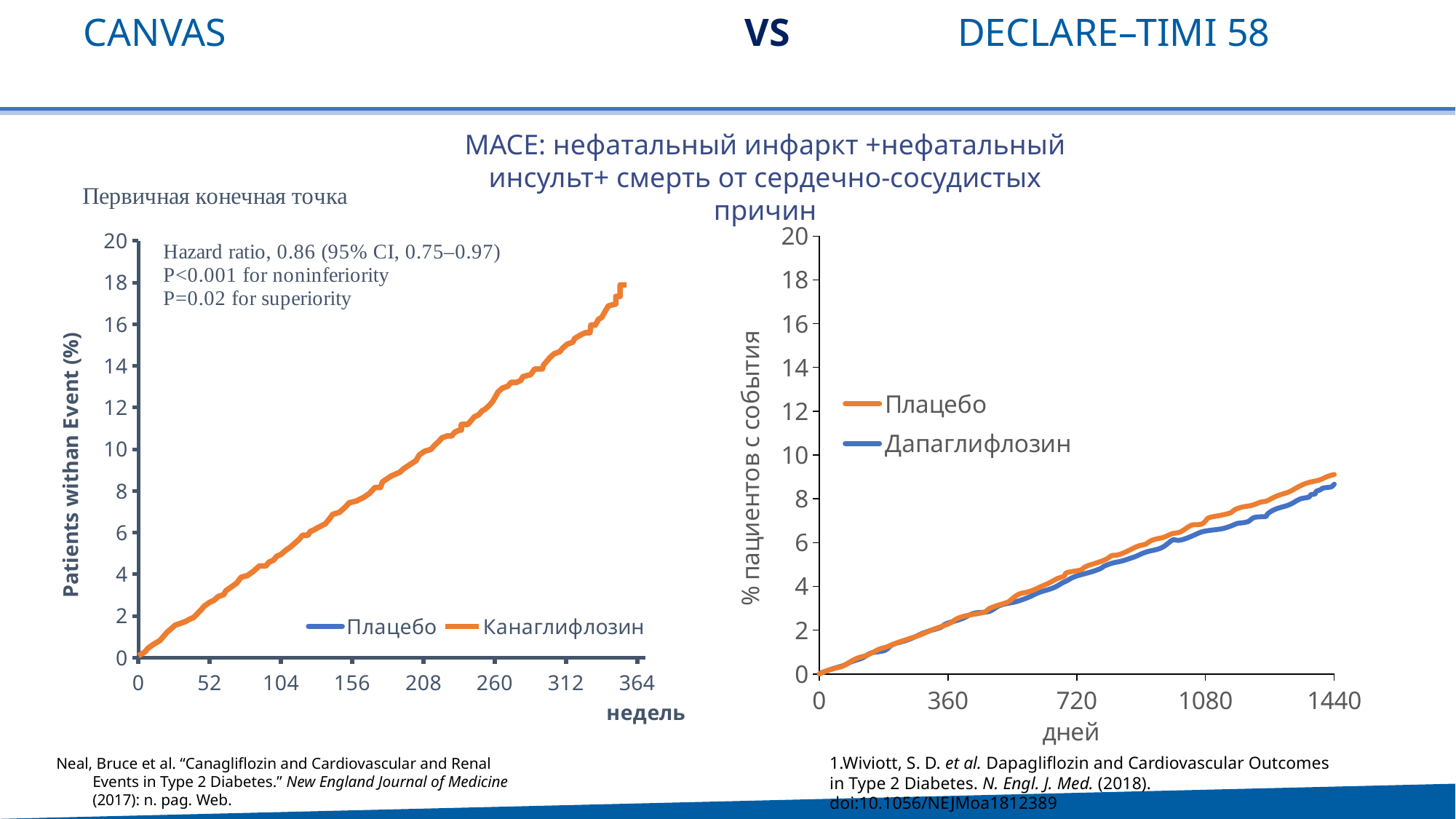
How many series does the legend of the CANVAS chart on the left list? 2 In the DECLARE–TIMI 58 chart on the right, does the Плацебо line rise or fall along the x axis? rise In the CANVAS chart on the left, is the value of the Канаглифлозин line at 208 weeks greater or less than 8? greater What is the x-axis unit label on the DECLARE–TIMI 58 chart on the right? дней In the DECLARE–TIMI 58 chart on the right, is the value of the Дапаглифлозин line at 1440 days greater or less than 6? greater How many series does the legend of the DECLARE–TIMI 58 chart on the right list? 2 In the DECLARE–TIMI 58 chart on the right, which series is drawn in orange? Плацебо In the DECLARE–TIMI 58 chart on the right, is the value of the Плацебо line at 720 days greater or less than 6? less What kind of chart is the CANVAS chart on the left? line chart In the DECLARE–TIMI 58 chart on the right, at 1080 days, which series has the higher value: Плацебо or Дапаглифлозин? Плацебо In the CANVAS chart on the left, does the Канаглифлозин line rise or fall as weeks increase? rise